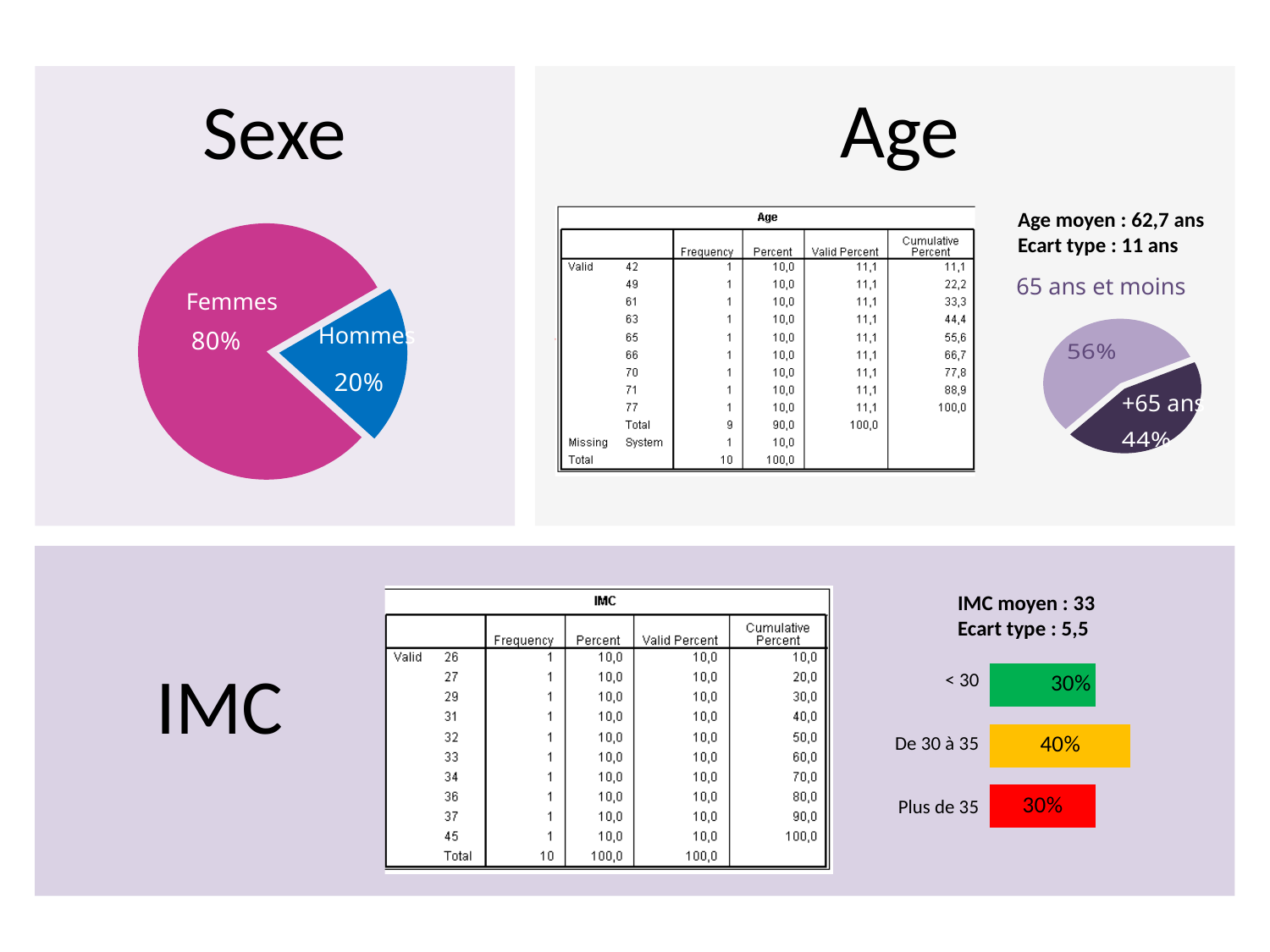
How many slices does the Age pie chart have? 2 In the IMC bar chart, which category has the highest value? De 30 à 35 In the IMC bar chart, what is the difference between De 30 à 35 and Plus de 35? 10% What kind of chart is shown under the Sexe heading? Pie chart In the Sexe pie chart, what share is Hommes? 20% In the Age pie chart, what share is +65 ans? 44% In the IMC bar chart, what is the value for De 30 à 35? 40% In the Sexe pie chart, which slice is larger, Femmes or Hommes? Femmes In the Sexe pie chart, what share is Femmes? 80% In the Age pie chart, what share is 65 ans et moins? 56% In the Age pie chart, which slice is the largest? 65 ans et moins In the Sexe pie chart, what is the difference between the Femmes and Hommes shares? 60%